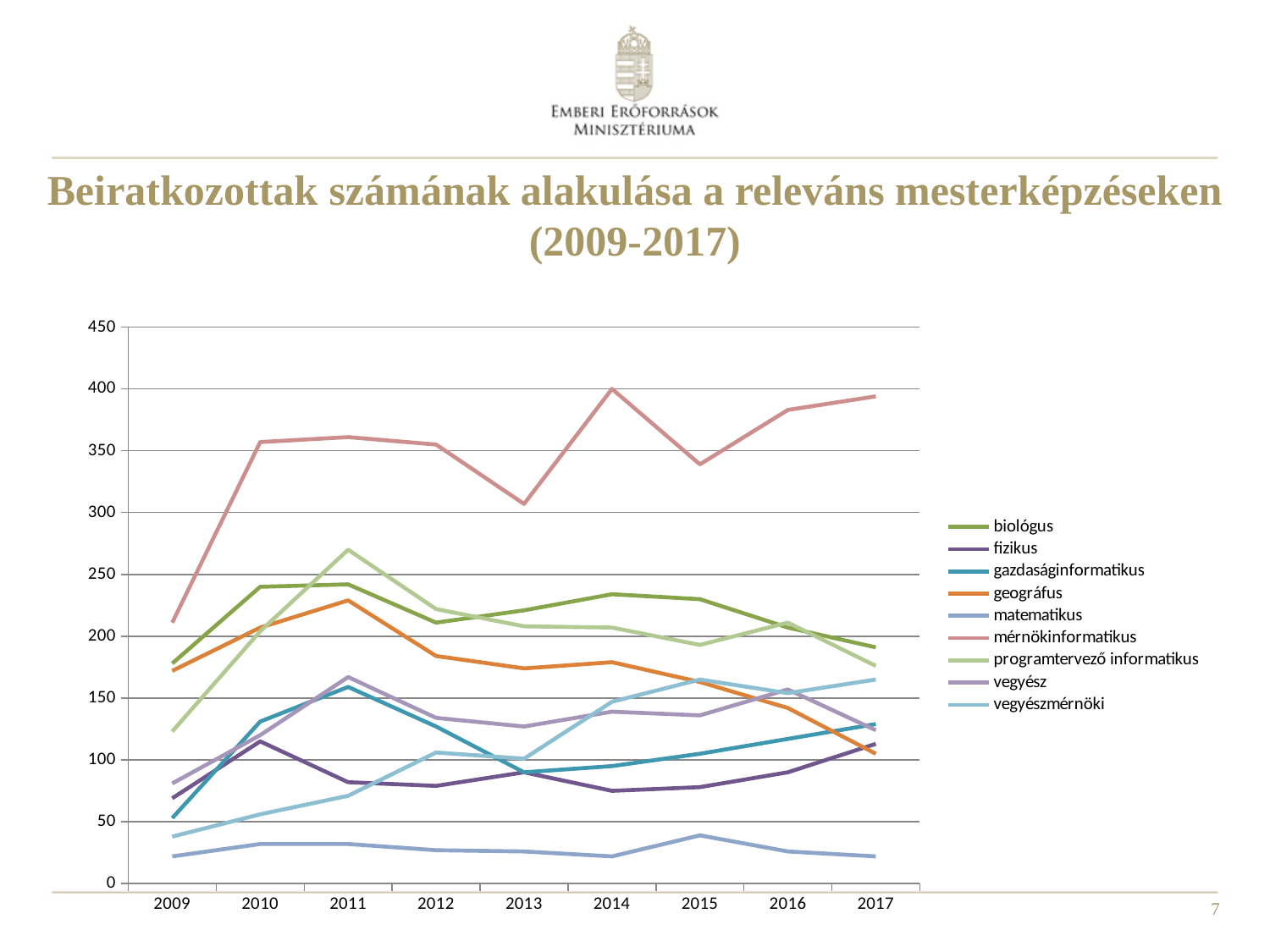
Which series has the highest value in 2014? mérnökinformatikus What kind of chart is shown on the slide? line chart What is the title of the chart on the slide? Beiratkozottak számának alakulása a releváns mesterképzéseken (2009-2017) Does the vegyészmérnöki series rise or fall from 2009 to 2015? rise In which year does the mérnökinformatikus series reach its highest value? 2014 In 2011, which is larger: biológus or programtervező informatikus? programtervező informatikus Is the value for matematikus in 2015 greater or less than 50? less Which series has the lowest value in 2017? matematikus Is the value for mérnökinformatikus in 2014 greater or less than 350? greater How many years are shown on the x axis? 9 How many series does the legend list? 9 Is the value for geográfus in 2017 greater or less than 150? less